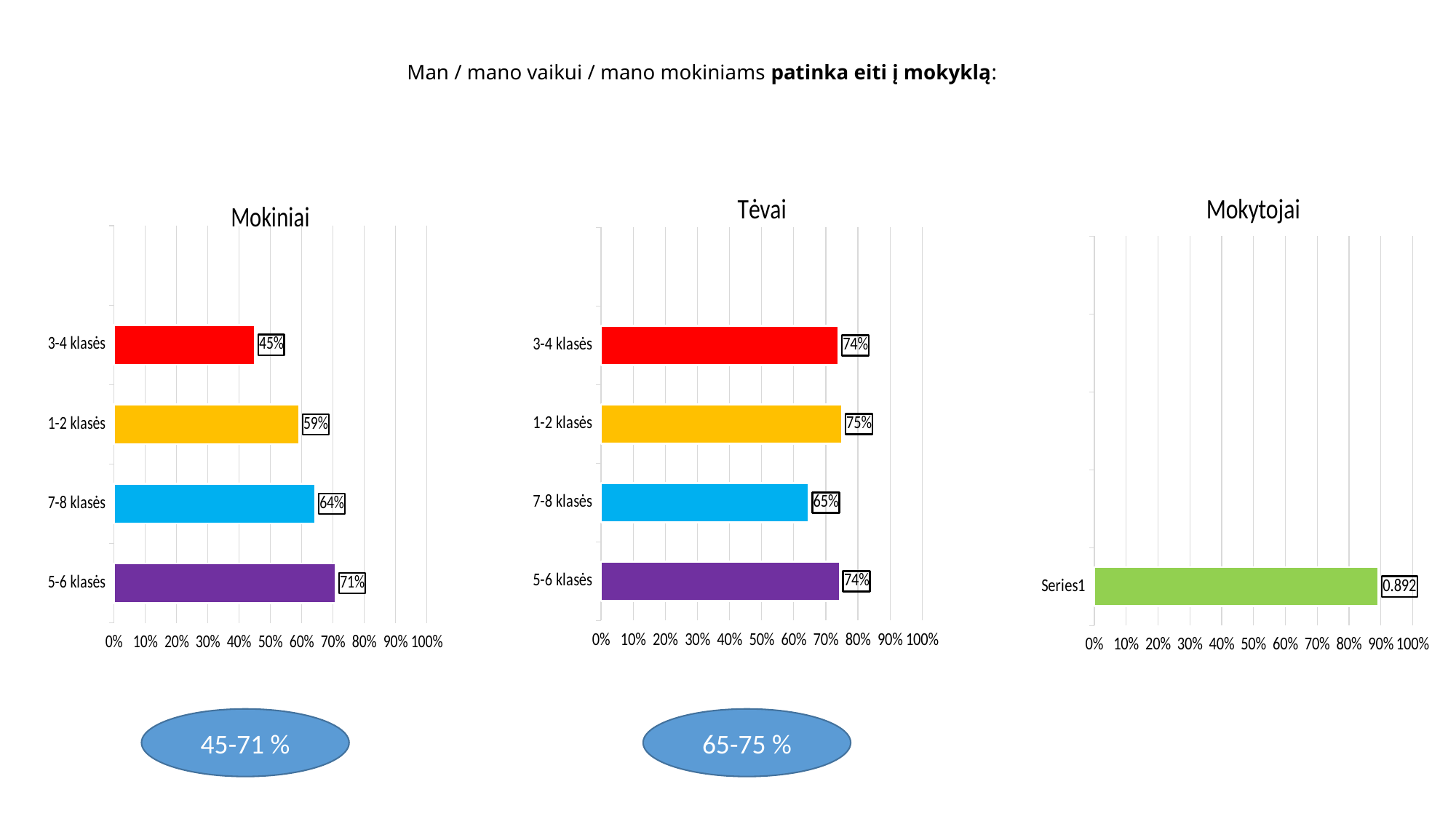
What kind of chart is the Tėvai chart? bar chart In the Mokiniai chart, what is the value for 3-4 klasės? 45% In the Tėvai chart, which category has the lowest value? 7-8 klasės How many categories are shown in the Mokiniai chart? 4 In the Mokiniai chart, what is the difference between the values for 5-6 klasės and 1-2 klasės? 12% In the Mokiniai chart, which category has the highest value? 5-6 klasės In the Mokytojai chart, what is the value shown for Series1? 0.892 In the Mokiniai chart, which category has the lowest value? 3-4 klasės In the Tėvai chart, what is the difference between the values for 1-2 klasės and 7-8 klasės? 10% In the Tėvai chart, which is larger: the value for 1-2 klasės or the value for 7-8 klasės? 1-2 klasės What is the title of the chart on the right of the slide? Mokytojai In the Tėvai chart, what is the value for 7-8 klasės? 65%